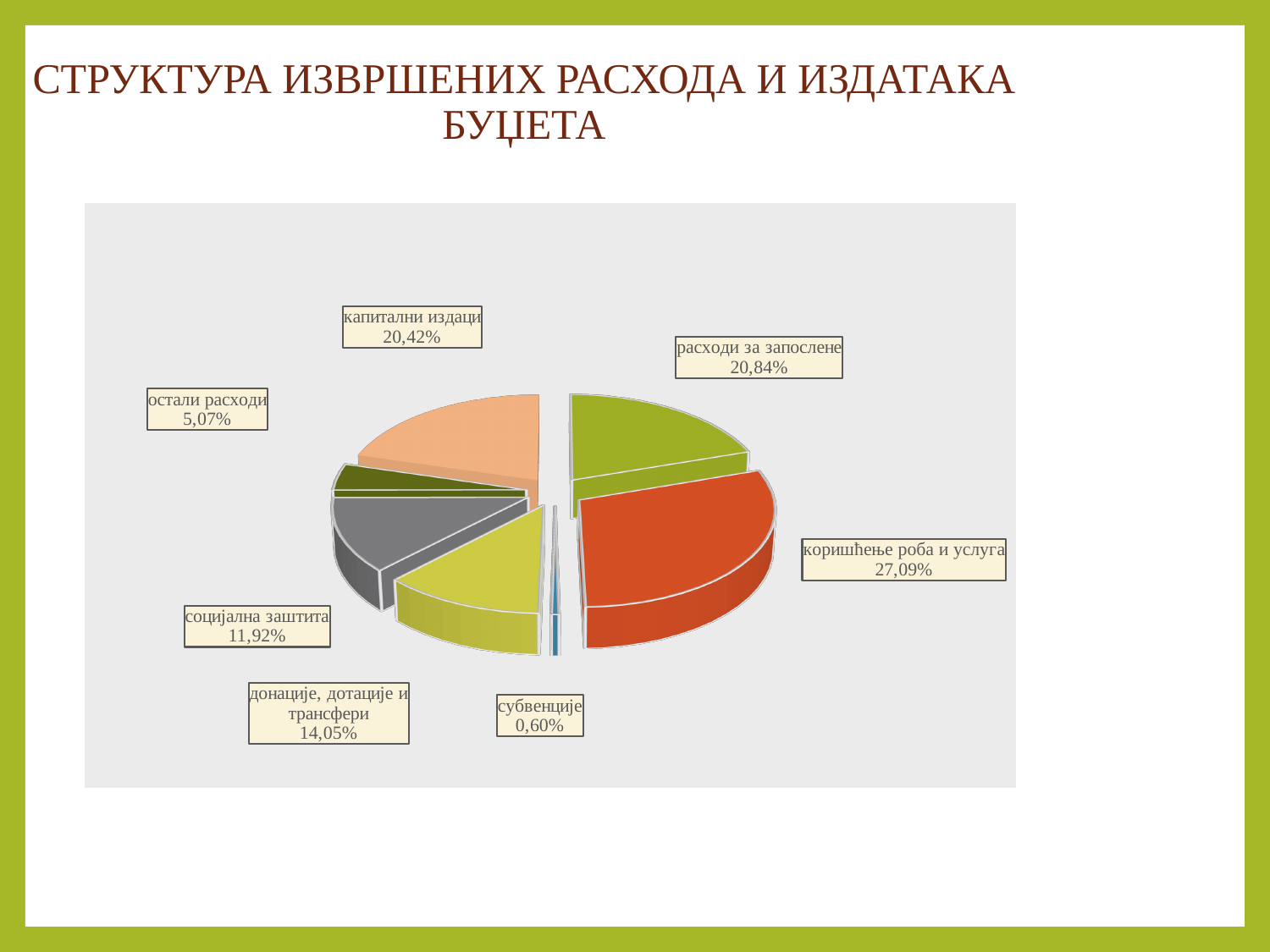
What is the value shown for субвенције? 0,60% What kind of chart is shown on the slide? pie chart How many slices does the pie chart have? 7 Which is larger, the share for социјална заштита or the share for остали расходи? социјална заштита What is the difference between the shares of коришћење роба и услуга and социјална заштита? 15,17% Which category has the largest share of the pie? коришћење роба и услуга What is the value shown for донације, дотације и трансфери? 14,05% What is the value shown for капитални издаци? 20,42% What is the value shown for расходи за запослене? 20,84% Which category has the smallest share of the pie? субвенције What share of the pie does коришћење роба и услуга have? 27,09% What is the title of the slide containing the pie chart? СТРУКТУРА ИЗВРШЕНИХ РАСХОДА И ИЗДАТАКА БУЏЕТА